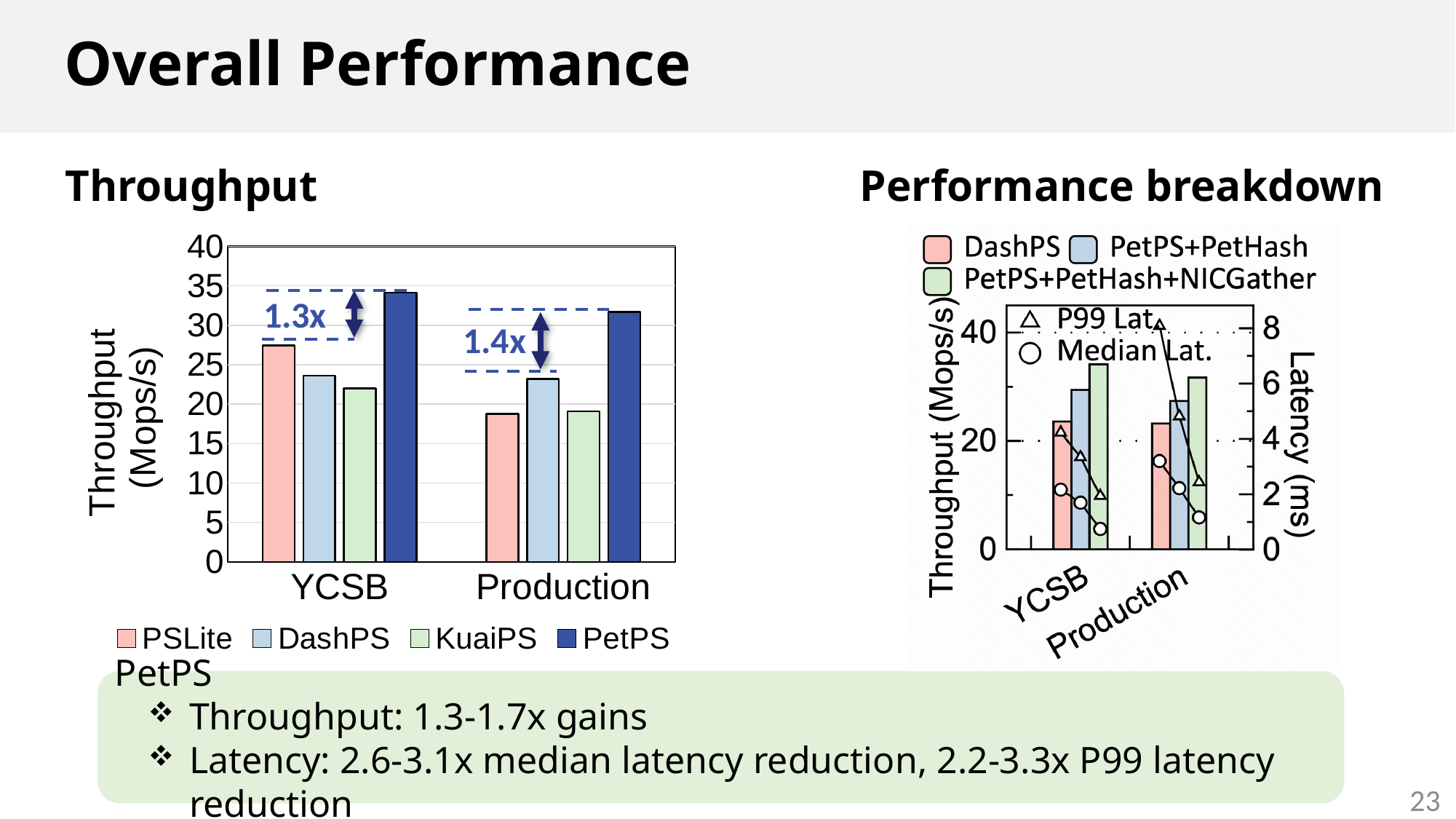
On the Throughput chart, is the PSLite value for Production greater or less than 20? less On the Throughput chart, how many workload categories are shown on the x axis? 2 On the Throughput chart, for YCSB, which is larger: PSLite or DashPS? PSLite On the Throughput chart, is the PetPS value for YCSB greater or less than 30? greater On the Performance breakdown chart, which configuration has the highest throughput bar for Production? PetPS+PetHash+NICGather On the Performance breakdown chart, what is the label of the right-hand y axis? Latency (ms) On the Throughput chart, how many series does the legend list? 4 On the Performance breakdown chart, how many bar series does the legend list? 3 On the Throughput chart, which system has the highest throughput for YCSB? PetPS On the Throughput chart, what speedup is annotated for PetPS on the Production workload? 1.4x On the Throughput chart, which system has the highest throughput for Production? PetPS On the Throughput chart, what kind of chart is it? bar chart